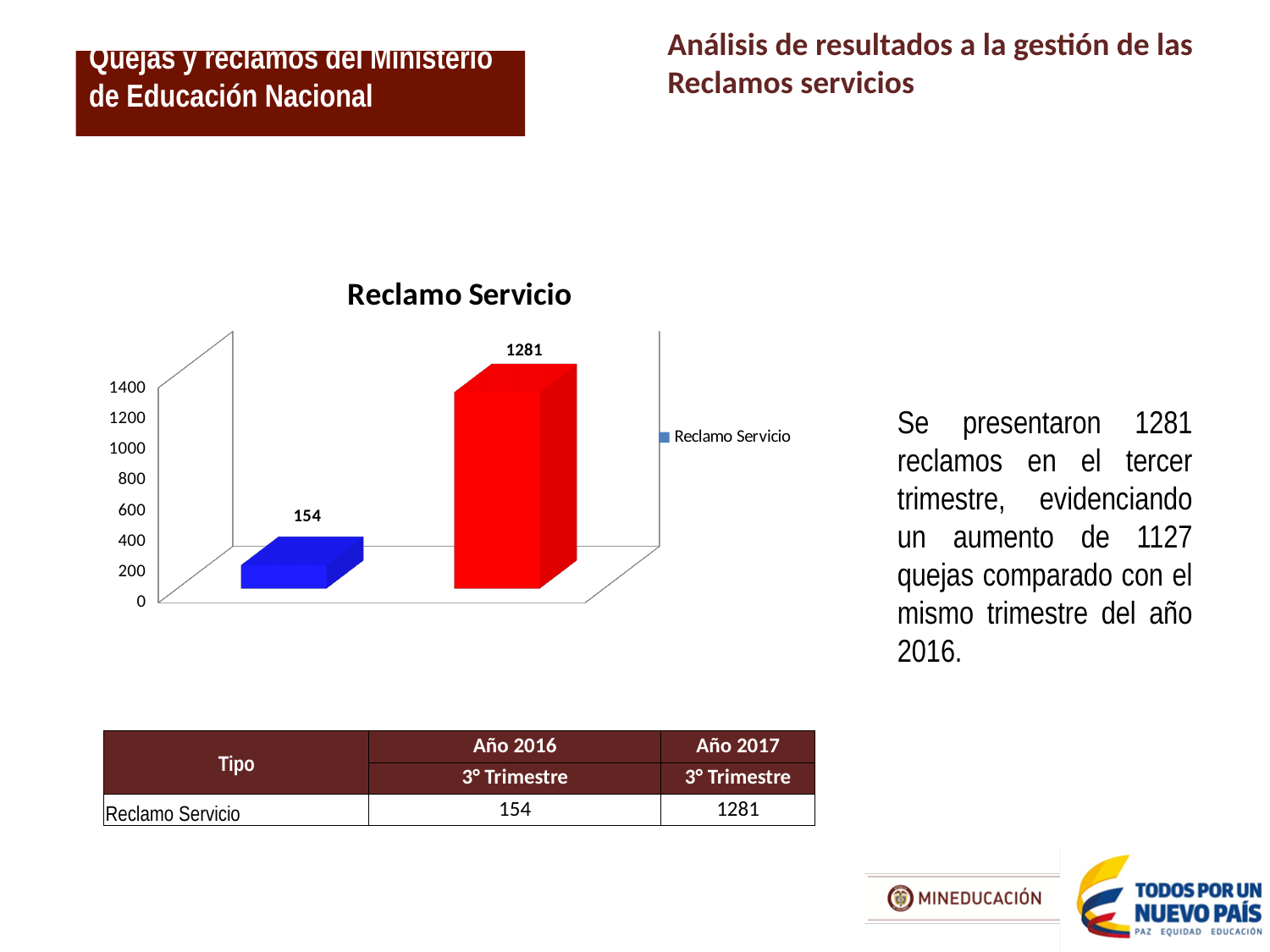
What is the name of the series shown in the chart legend? Reclamo Servicio Do the bar values rise or fall from left to right in the chart? rise What is the title of the chart? Reclamo Servicio Is the value of the red bar greater or less than 1000? greater Which bar has the higher value, the blue bar or the red bar? the red bar What type of chart is shown on the slide? bar chart What is the difference between the value of the red bar and the value of the blue bar? 1127 Is the value of the blue bar greater or less than 400? less What value is labelled on the blue bar in the chart? 154 How many series does the chart legend list? 1 How many bars are plotted in the chart? 2 What value is labelled on the red bar in the chart? 1281